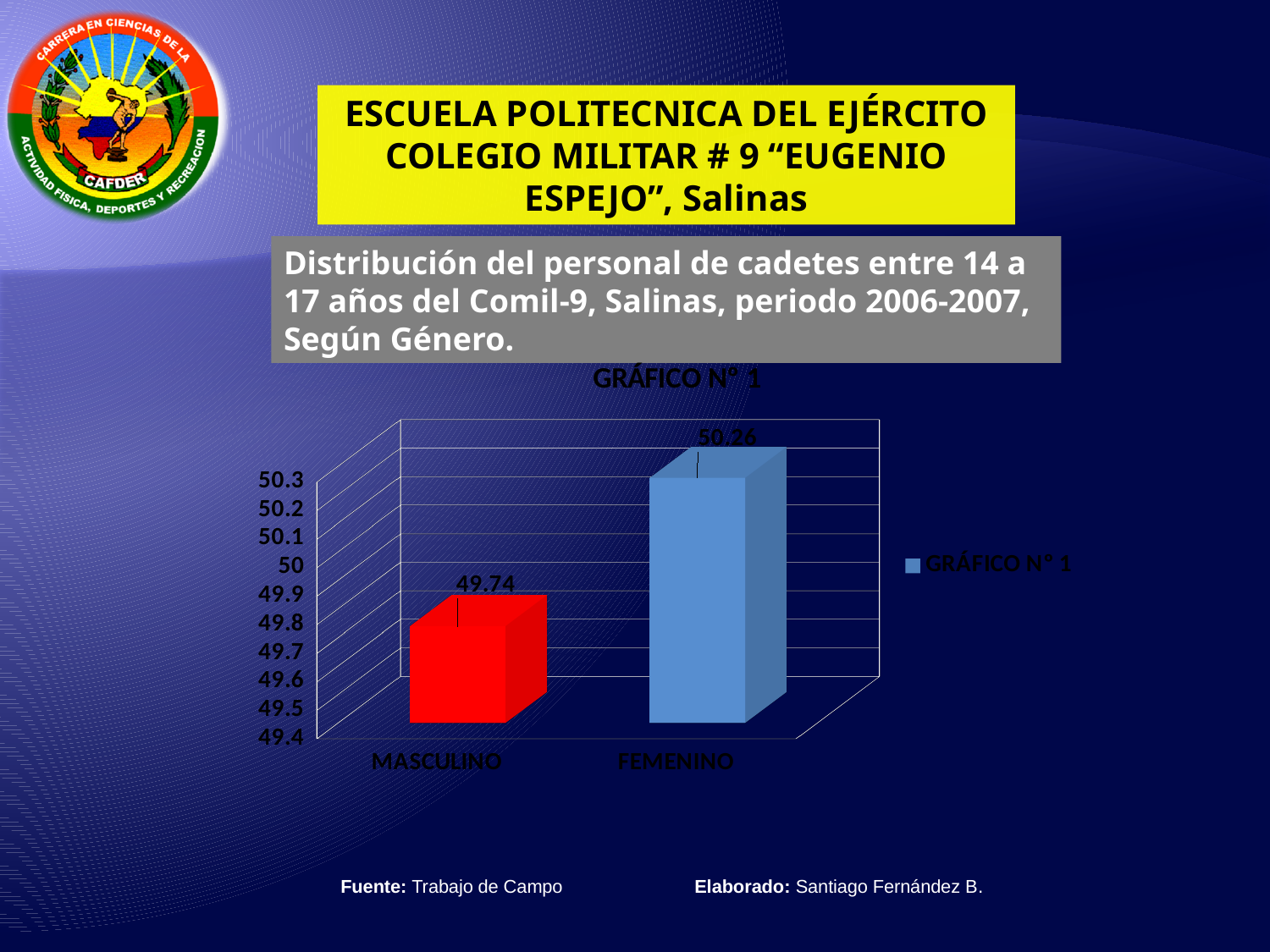
What kind of chart is shown? bar chart What is the value for FEMENINO? 50.26 Is the value for MASCULINO greater or less than 50? less Which is larger, the value for MASCULINO or the value for FEMENINO? FEMENINO How many categories are shown on the x axis? 2 Which category has the highest value? FEMENINO Is the value for FEMENINO greater or less than 50? greater What is the title of the chart? GRÁFICO N° 1 What is the value for MASCULINO? 49.74 How many series does the legend list? 1 Which category has the lowest value? MASCULINO What is the difference between the values for FEMENINO and MASCULINO? 0.52